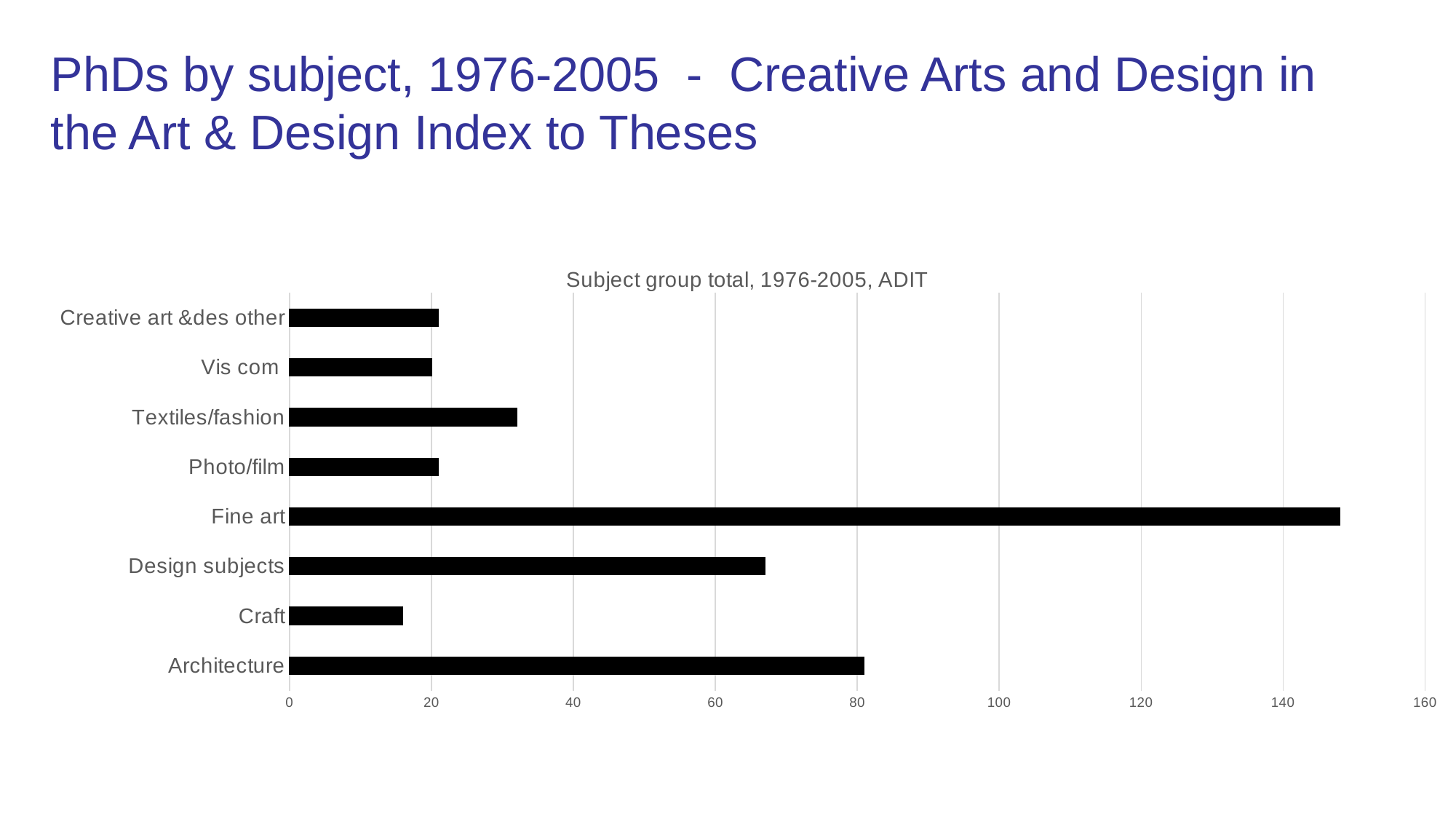
How many subject categories are plotted in the chart? 8 Is the value for Craft greater or less than 20? less Is the value for Design subjects greater or less than 80? less Is the value for Architecture greater or less than 60? greater Which subject has the highest total? Fine art Which has the larger value, Architecture or Design subjects? Architecture What kind of chart is shown on the slide? bar chart What is the title of the chart? Subject group total, 1976-2005, ADIT Which has the larger value, Textiles/fashion or Photo/film? Textiles/fashion Which subject has the lowest total? Craft